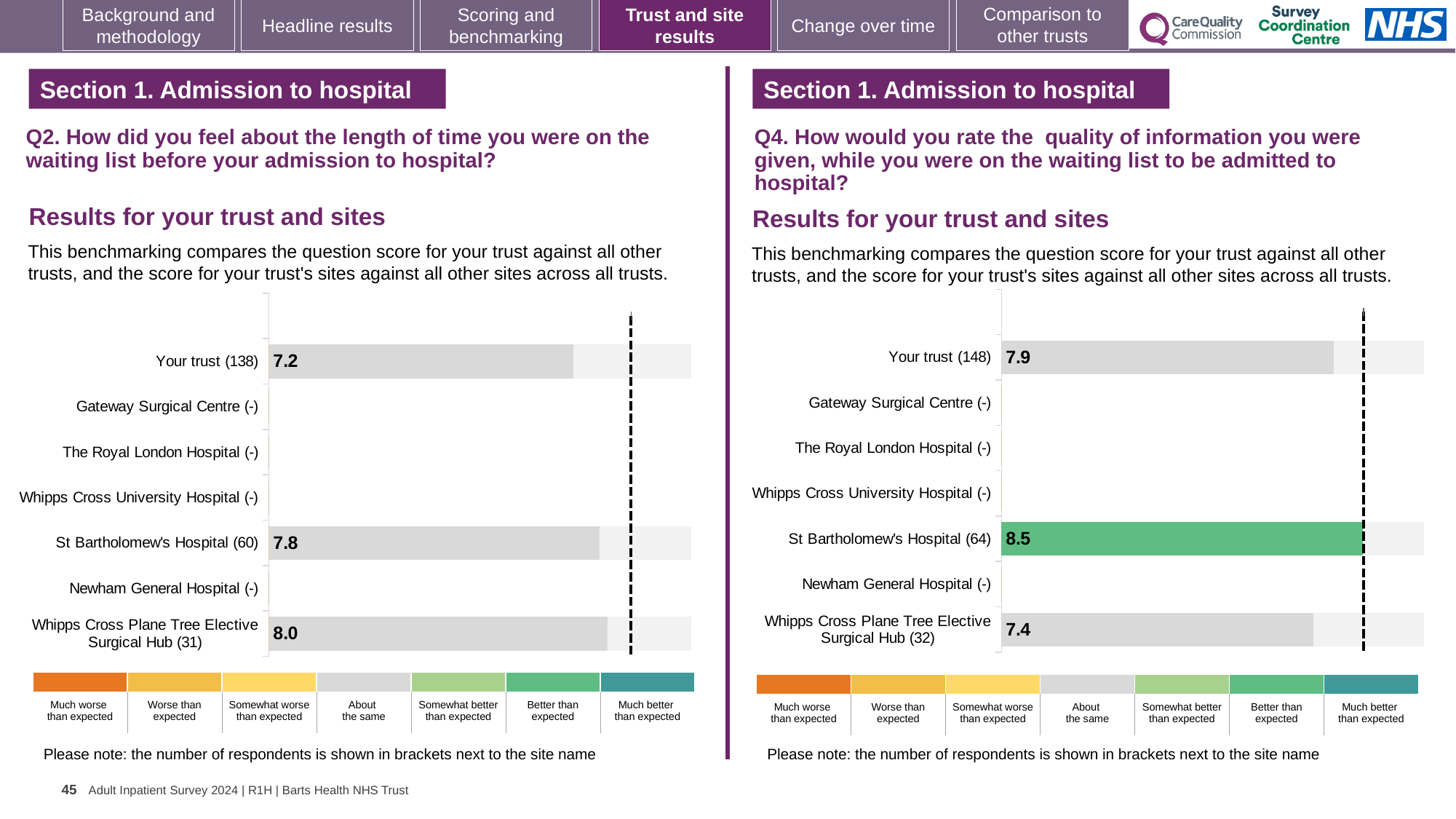
In the Q4 chart on the right, what is the score for St Bartholomew's Hospital (64)? 8.5 In the Q2 chart on the left, what is the score for Whipps Cross Plane Tree Elective Surgical Hub (31)? 8.0 How many site or trust rows are listed on the vertical axis of the Q2 chart on the left? 7 In the Q4 chart on the right, which is larger: the score for St Bartholomew's Hospital (64) or the score for Whipps Cross Plane Tree Elective Surgical Hub (32)? St Bartholomew's Hospital (64) In the Q2 chart on the left, what is the score for Your trust (138)? 7.2 In the Q2 chart on the left, what is the difference between the score for Whipps Cross Plane Tree Elective Surgical Hub (31) and the score for Your trust (138)? 0.8 In the Q2 chart on the left, what is the score for St Bartholomew's Hospital (60)? 7.8 In the Q2 chart on the left, which site or trust row has the highest score shown? Whipps Cross Plane Tree Elective Surgical Hub (31) In the Q4 chart on the right, what is the score for Your trust (148)? 7.9 In the Q4 chart on the right, what is the score for Whipps Cross Plane Tree Elective Surgical Hub (32)? 7.4 In the Q4 chart on the right, which site or trust row has the lowest score shown? Whipps Cross Plane Tree Elective Surgical Hub (32) In the Q4 chart on the right, what is the difference between the score for St Bartholomew's Hospital (64) and the score for Your trust (148)? 0.6